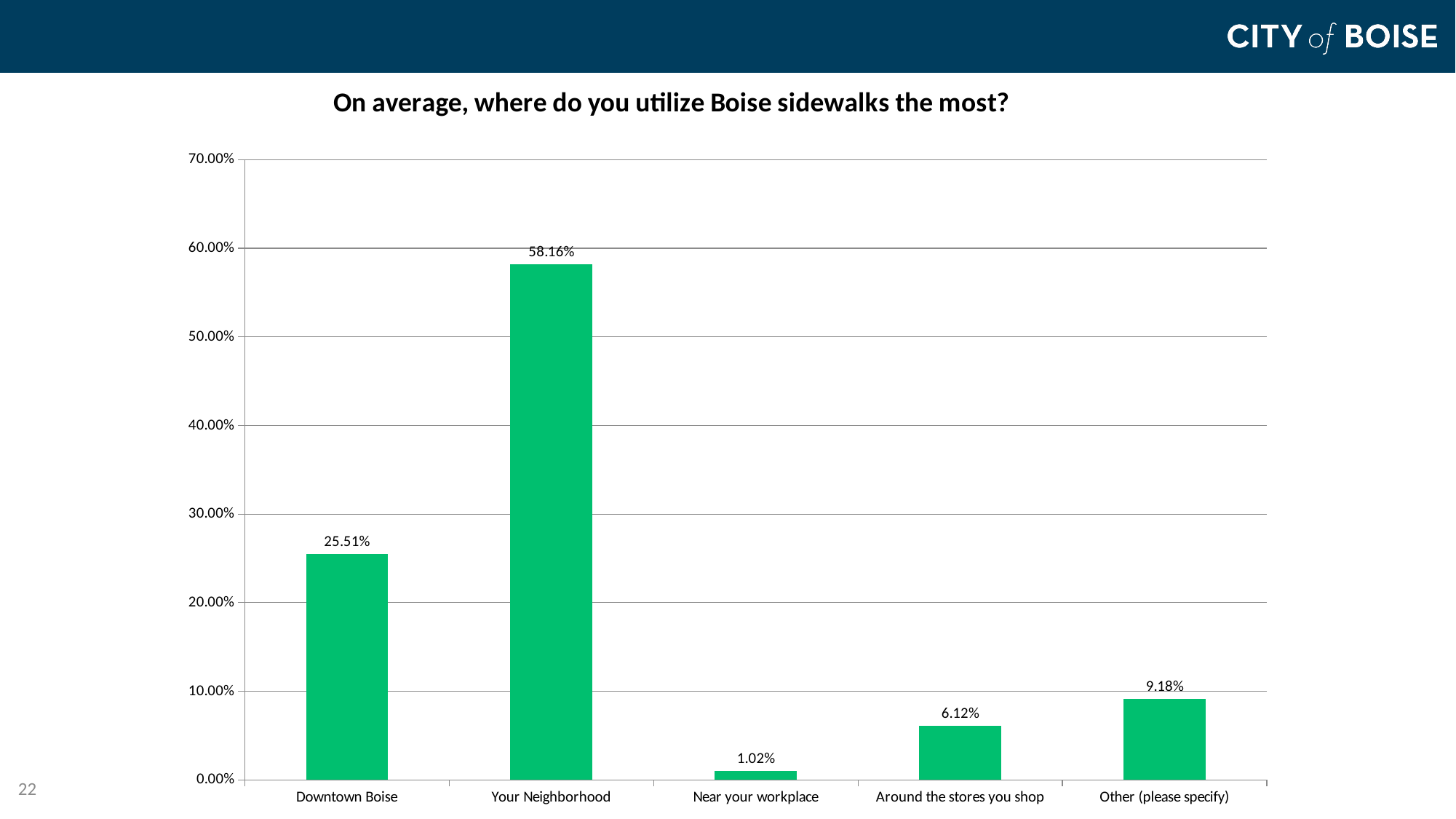
What percentage of respondents said they utilize Boise sidewalks the most in Your Neighborhood? 58.16% Which is larger, the value for Around the stores you shop or the value for Other (please specify)? Other (please specify) What is the difference between the values for Other (please specify) and Around the stores you shop? 3.06% What is the value shown for Other (please specify)? 9.18% Which category has the lowest value? Near your workplace What is the value shown for Near your workplace? 1.02% What is the value shown for Downtown Boise? 25.51% How many categories are shown on the x axis? 5 What is the title of the chart? On average, where do you utilize Boise sidewalks the most? Which category has the highest value? Your Neighborhood What is the difference between the values for Your Neighborhood and Downtown Boise? 32.65% What kind of chart is shown on the slide? Bar chart